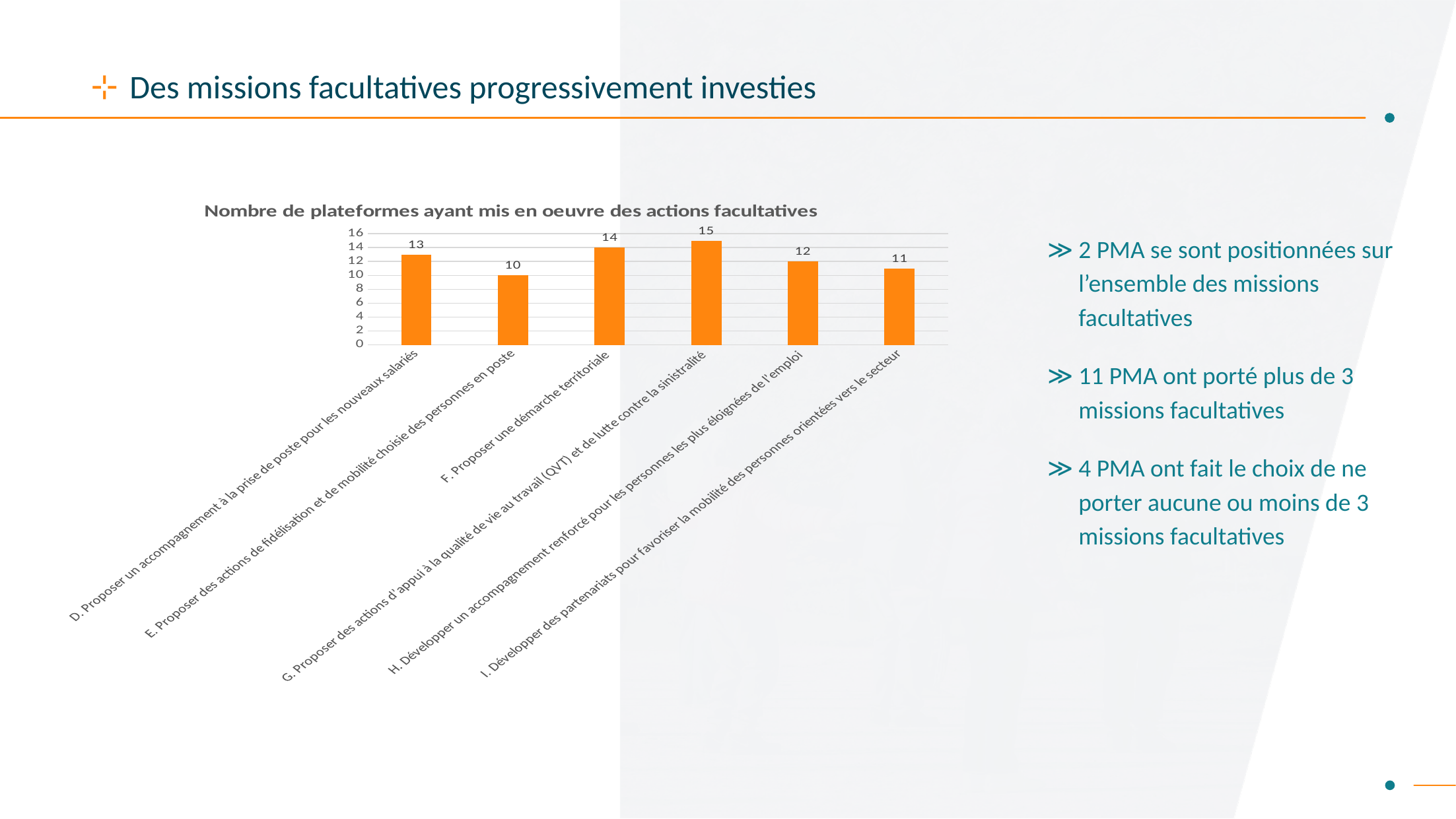
Which category has the lowest value? E. Proposer des actions de fidélisation et de mobilité choisie des personnes en poste What is the maximum value shown on the vertical axis? 16 What is the title of the chart? Nombre de plateformes ayant mis en oeuvre des actions facultatives What is the value for category I (Développer des partenariats pour favoriser la mobilité des personnes orientées vers le secteur)? 11 Which category has the highest value? G. Proposer des actions d'appui à la qualité de vie au travail (QVT) et de lutte contre la sinistralité What is the difference between the values for category G and category E? 5 How many categories are shown in the chart? 6 What is the value for category D (Proposer un accompagnement à la prise de poste pour les nouveaux salariés)? 13 Which is larger, the value for category H or the value for category I? H. Développer un accompagnement renforcé pour les personnes les plus éloignées de l'emploi What is the value for category E (Proposer des actions de fidélisation et de mobilité choisie des personnes en poste)? 10 What kind of chart is shown on the slide? Bar chart What is the value for category F (Proposer une démarche territoriale)? 14